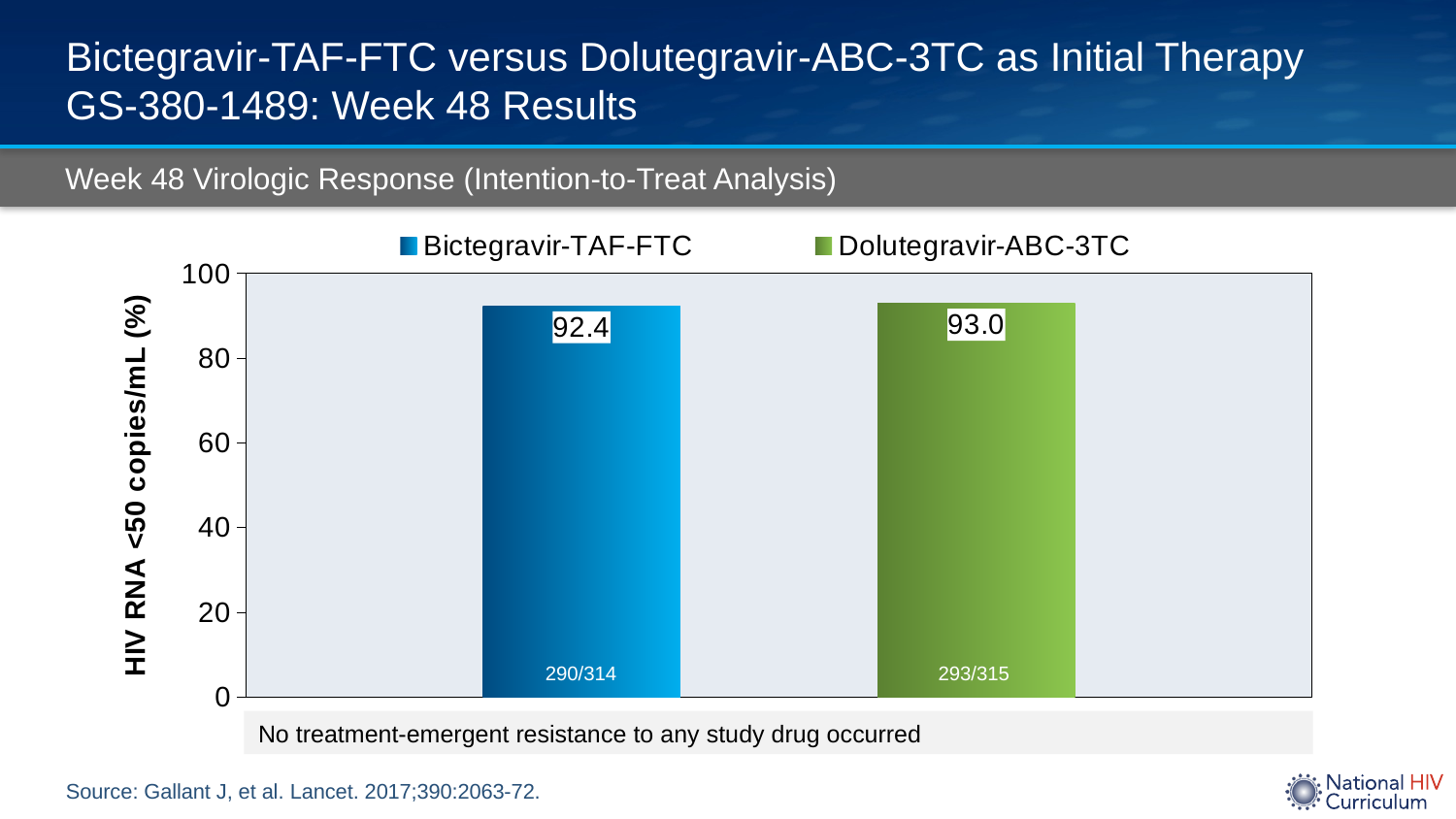
What is the label of the y axis? HIV RNA <50 copies/mL (%) How many bars are plotted in the chart? 2 What is the value for Bictegravir-TAF-FTC? 92.4 What fraction of participants is shown inside the Bictegravir-TAF-FTC bar? 290/314 Is the value for Bictegravir-TAF-FTC greater or less than 80? greater What fraction of participants is shown inside the Dolutegravir-ABC-3TC bar? 293/315 What is the title of the chart? Week 48 Virologic Response (Intention-to-Treat Analysis) What kind of chart is shown on the slide? Bar chart What is the difference between the Dolutegravir-ABC-3TC and Bictegravir-TAF-FTC values? 0.6 How many series does the legend list? 2 What is the value for Dolutegravir-ABC-3TC? 93.0